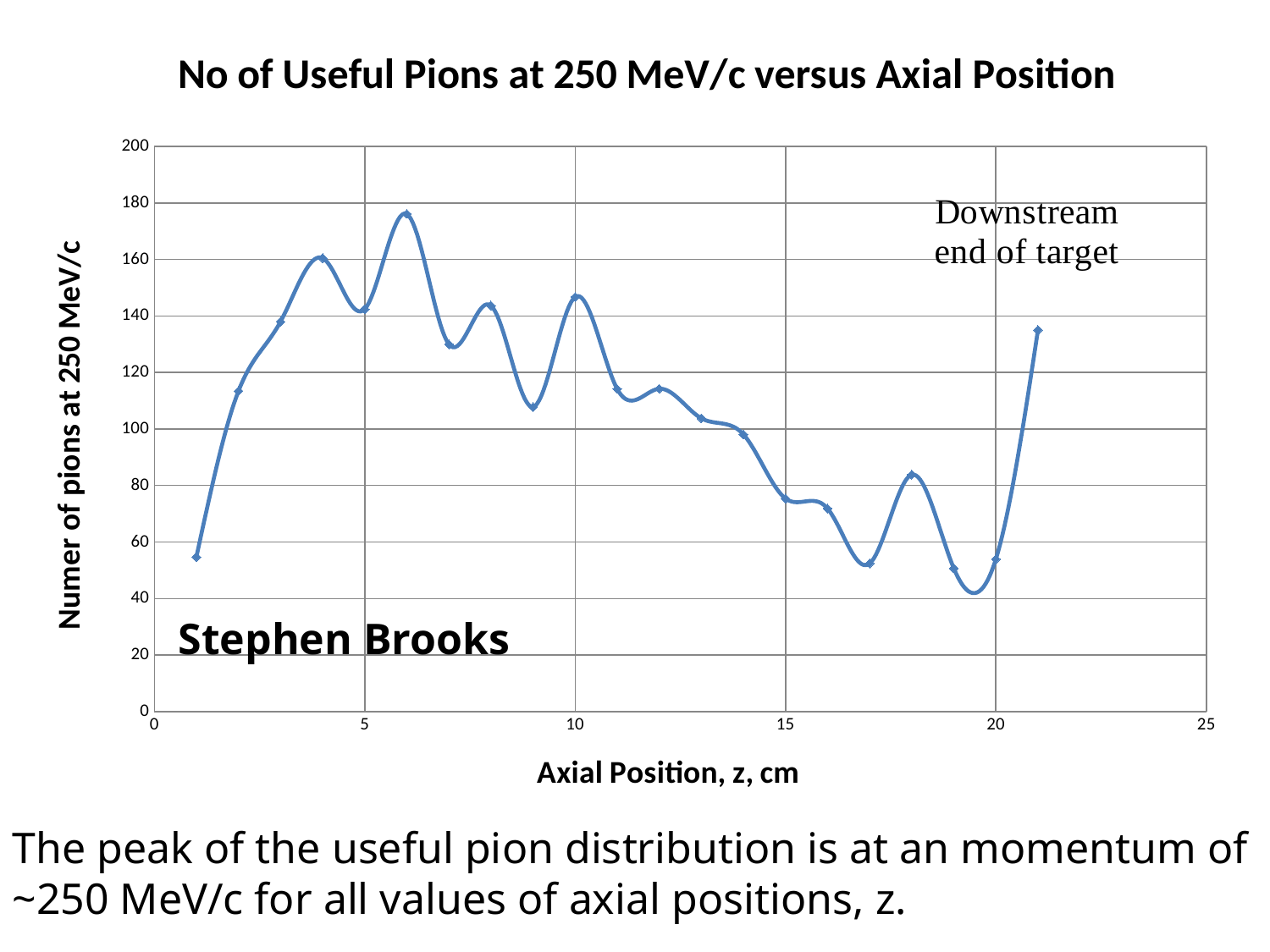
How many data points are plotted on the chart? 21 At which axial position z does the number of pions reach its highest value? 6 Is the number of pions at z = 17 cm greater or less than 60? less Do the values generally rise or fall between z = 10 cm and z = 17 cm? fall Which has more pions: z = 18 cm or z = 19 cm? z = 18 cm Is the number of pions at z = 6 cm greater or less than 160? greater What is the label of the x axis? Axial Position, z, cm Is the number of pions at z = 15 cm greater or less than 80? less What kind of chart is shown on the slide? line chart Which has more pions: z = 4 cm or z = 5 cm? z = 4 cm